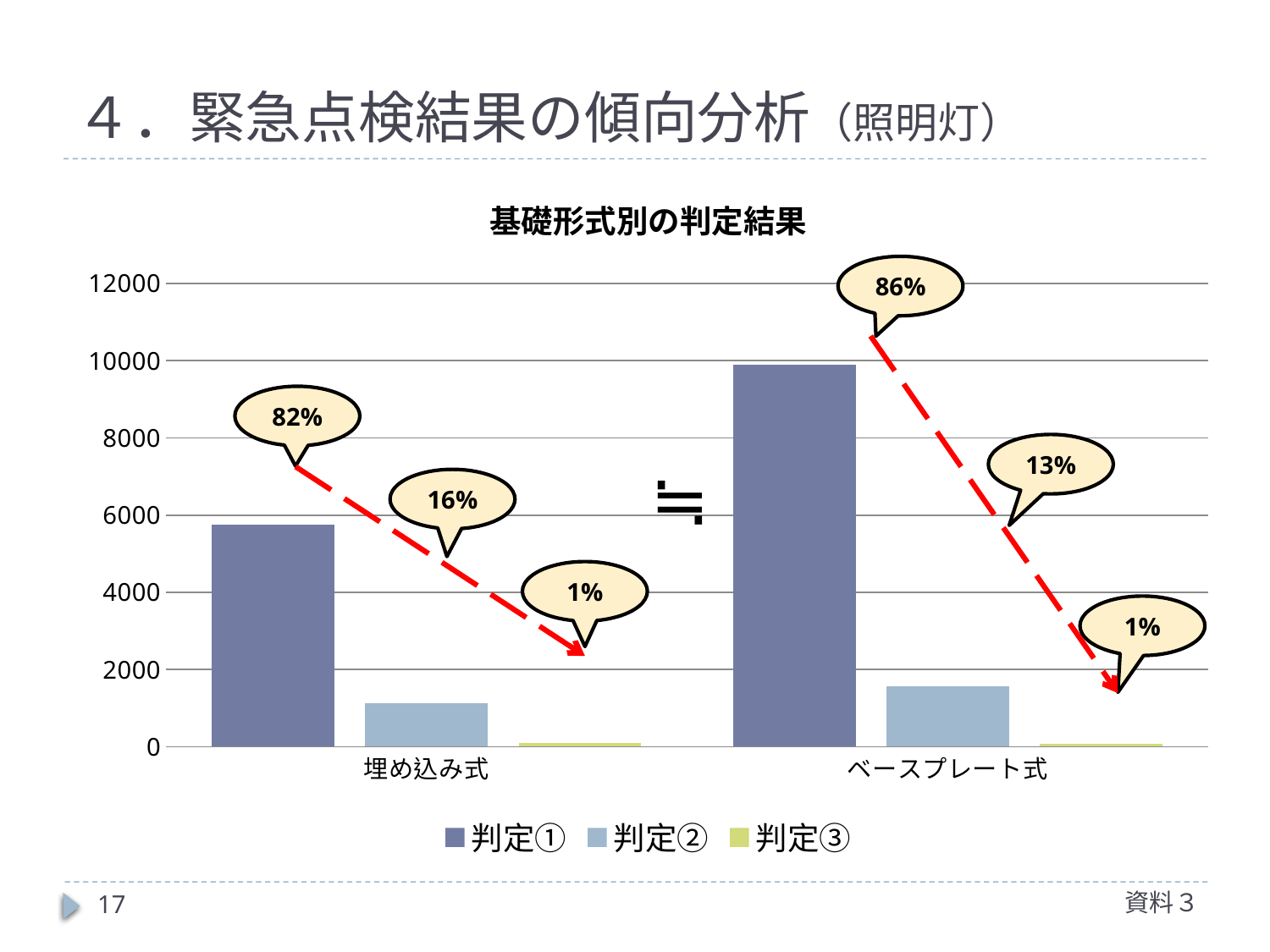
Is the 判定① value for 埋め込み式 greater or less than 4000? greater Which category has the larger 判定① value, 埋め込み式 or ベースプレート式? ベースプレート式 Is the 判定② value for ベースプレート式 greater or less than 2000? less What percentage is shown in the callout above the 判定① bar for 埋め込み式? 82% What percentage is shown in the callout above the 判定② bar for ベースプレート式? 13% What kind of chart is shown on the slide? bar chart How many series does the legend list? 3 Within the 埋め込み式 category, which series has the lowest bar? 判定③ Which bar is the tallest in the chart? 判定① for ベースプレート式 What percentage is shown in the callout above the 判定① bar for ベースプレート式? 86% What is the title of the chart? 基礎形式別の判定結果 How many categories are shown on the x axis? 2